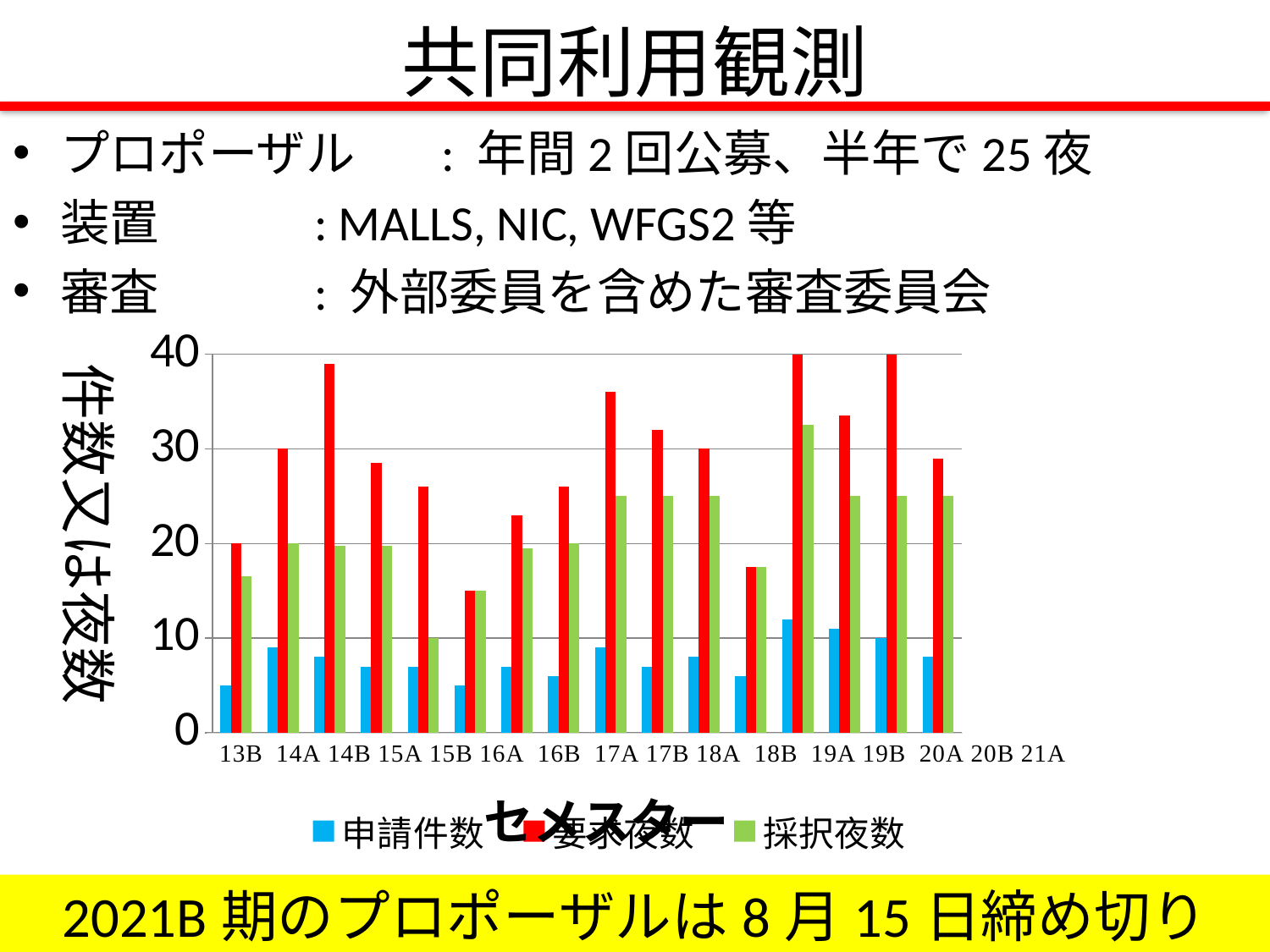
How many series does the legend list? 3 Which semester has the highest 採択夜数 value? 19B Which semester has the lowest 要求夜数 value? 16A Is the 採択夜数 value for 19B greater or less than 30? greater What are the three series named in the legend? 申請件数, 要求夜数, 採択夜数 Is the 申請件数 value for 13B greater or less than 10? less What is the title of the y axis? 件数又は夜数 For 13B, which is larger: 要求夜数 or 採択夜数? 要求夜数 Which semester has the lowest 採択夜数 value? 15B How many semester categories are shown on the x axis? 16 Is the 要求夜数 value for 13B greater or less than 30? less What kind of chart is shown on the slide? bar chart